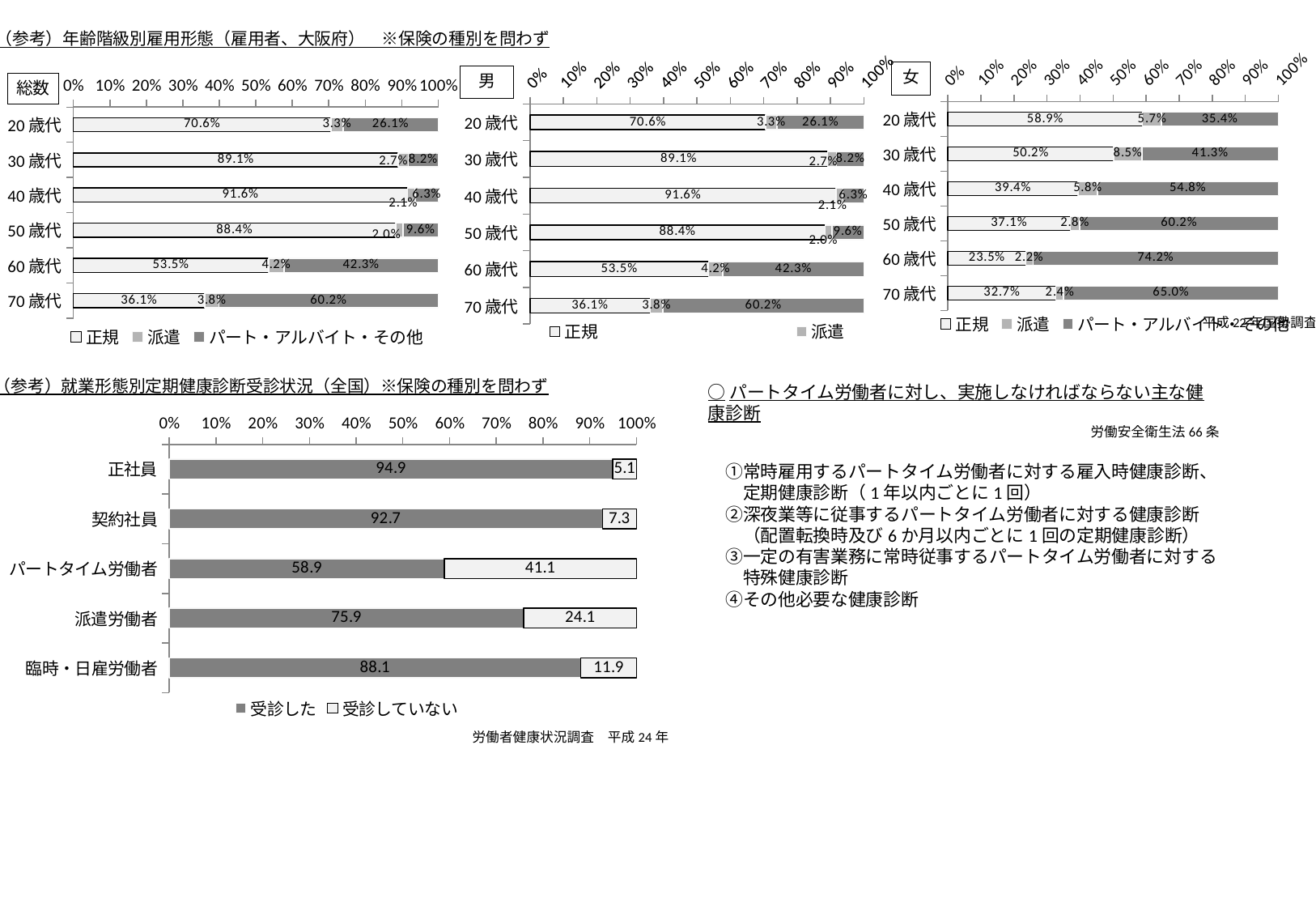
In the 女 chart, what is the パート・アルバイト・その他 value for 60歳代? 74.2% In the 総数 chart, which age group has the highest 正規 share? 40歳代 In the bottom-left chart (就業形態別定期健康診断受診状況), what is the difference between the 受診した values for 正社員 and 派遣労働者? 19.0 In the 女 chart, what is the 正規 value for 20歳代? 58.9% In the bottom-left chart (就業形態別定期健康診断受診状況), what is the 受診した value for パートタイム労働者? 58.9 In the bottom-left chart (就業形態別定期健康診断受診状況), which employment type has the highest 受診していない value? パートタイム労働者 In the 総数 chart, what is the 正規 value for 40歳代? 91.6% In the 女 chart, which is larger for 40歳代: 正規 or パート・アルバイト・その他? パート・アルバイト・その他 In the bottom-left chart (就業形態別定期健康診断受診状況), how many employment types are shown? 5 In the bottom-left chart (就業形態別定期健康診断受診状況), how many series does the legend list? 2 In the 女 chart, which age group has the lowest 正規 share? 60歳代 What kind of chart is the 総数 chart? Stacked bar chart